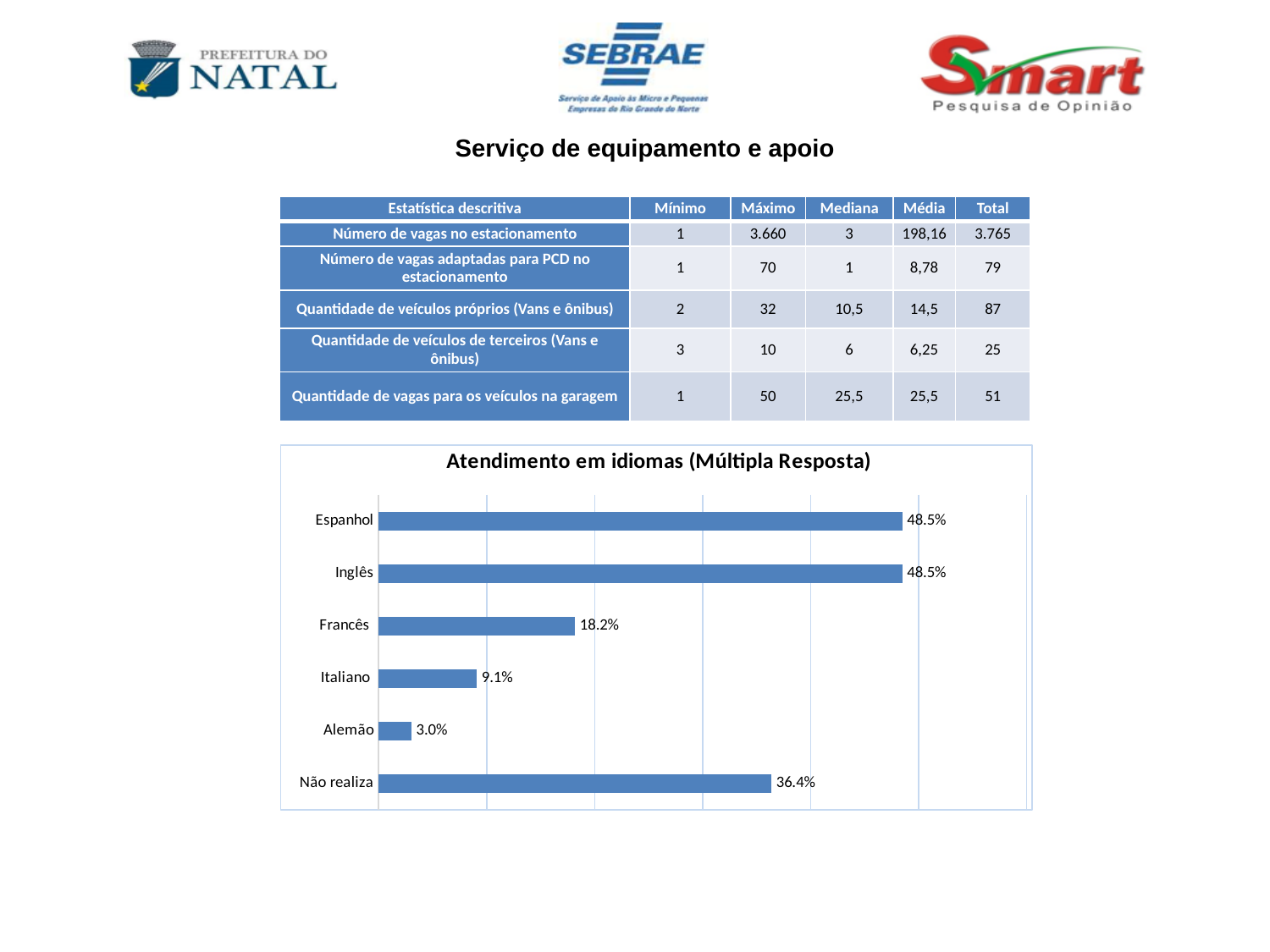
What is the value for Espanhol in the chart? 48.5% What is the value for Italiano in the chart? 9.1% What kind of chart is shown on the slide? Bar chart What is the difference between the values for Não realiza and Francês? 18.2% Which is larger, the value for Não realiza or the value for Francês? Não realiza What is the value for Francês in the chart? 18.2% What is the difference between the values for Inglês and Não realiza? 12.1% Which category has the lowest value in the chart? Alemão What is the value for Não realiza in the chart? 36.4% What is the title of the chart? Atendimento em idiomas (Múltipla Resposta) What is the difference between the values for Francês and Italiano? 9.1% How many categories are shown in the chart? 6